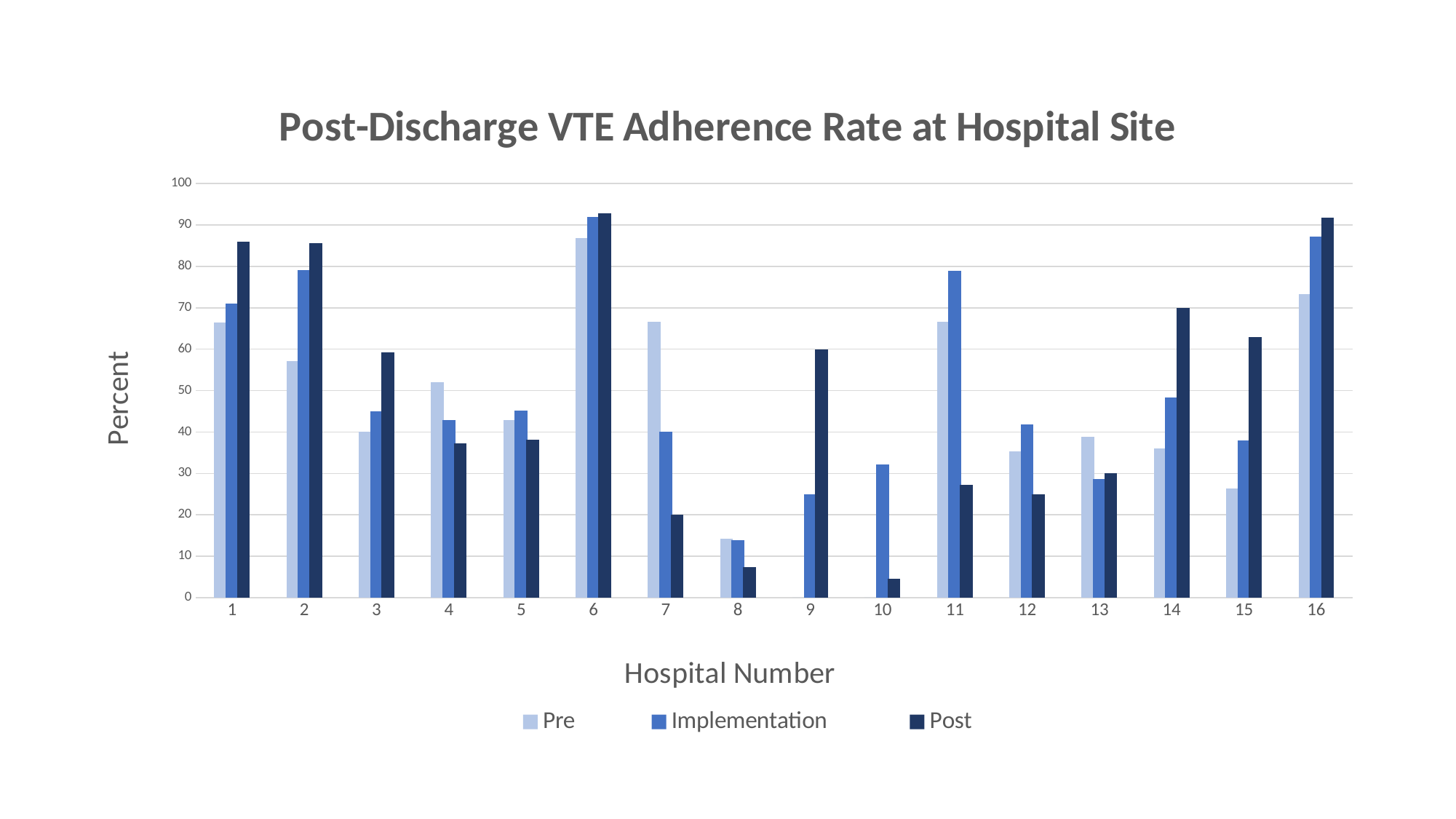
What is the title of the chart? Post-Discharge VTE Adherence Rate at Hospital Site What kind of chart is shown on the slide? bar chart How many hospitals are shown on the x axis? 16 Is the Pre value for hospital 8 greater or less than 20? less Is the Post value for hospital 1 greater or less than 80? greater Which hospital has the lowest Post value? 10 For hospital 14, which is larger, the Implementation value or the Post value? Post For hospital 7, which is larger, the Pre value or the Post value? Pre Which hospital has the highest Pre value? 6 What is the title of the y axis? Percent How many series does the legend list? 3 Is the Implementation value for hospital 9 greater or less than 30? less